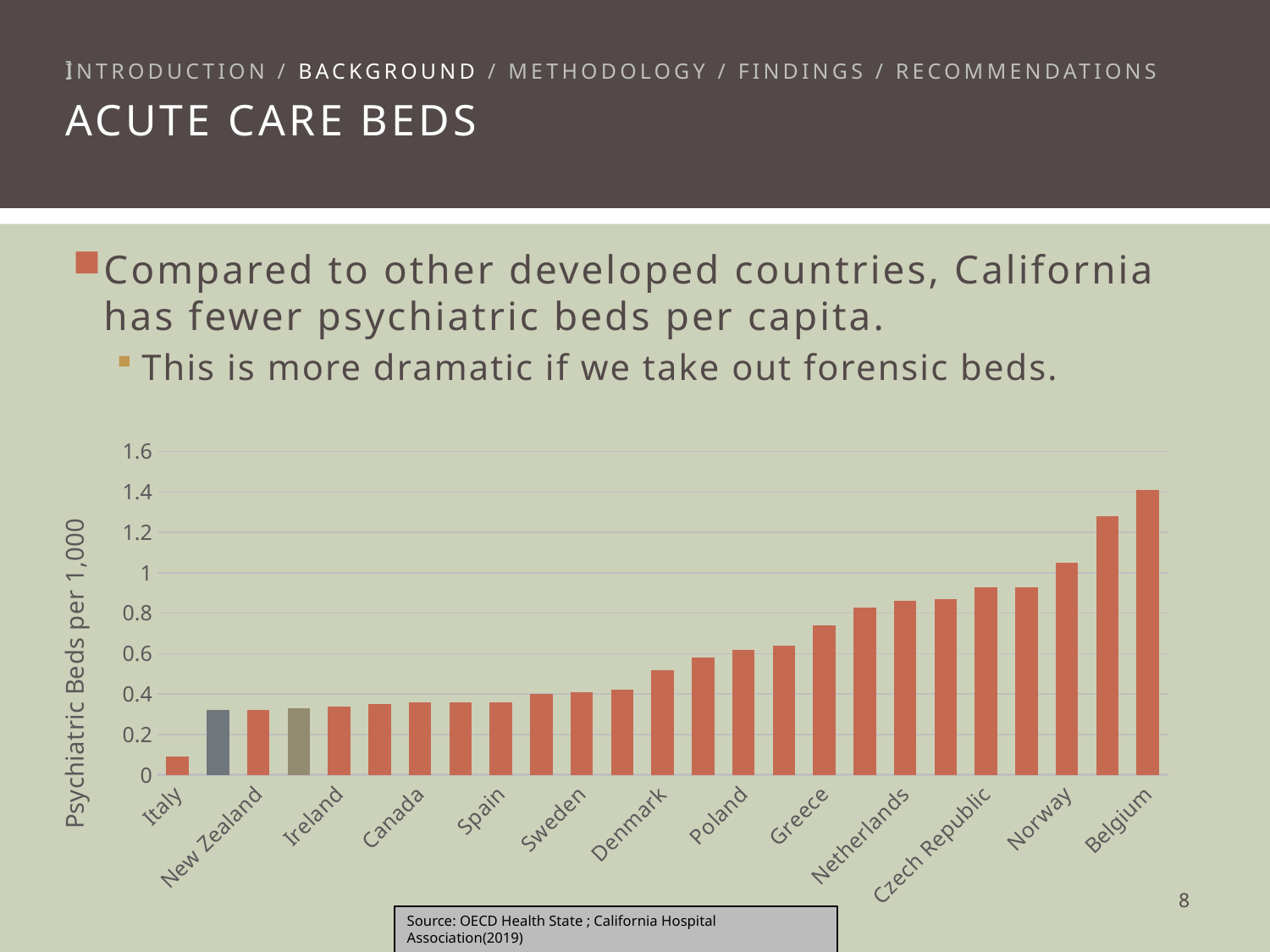
Is the value for Canada greater or less than 0.6? less Which country has the highest number of psychiatric beds per 1,000? Belgium Is the value for Czech Republic greater or less than 0.6? greater What kind of chart is shown on the slide? bar chart Which has more psychiatric beds per 1,000, Norway or Spain? Norway Which country has the lowest number of psychiatric beds per 1,000? Italy Do the bar values rise or fall moving from left to right along the x axis? rise Which has more psychiatric beds per 1,000, Greece or Sweden? Greece What is the title of the y axis? Psychiatric Beds per 1,000 Is the value for Italy greater or less than 0.2? less